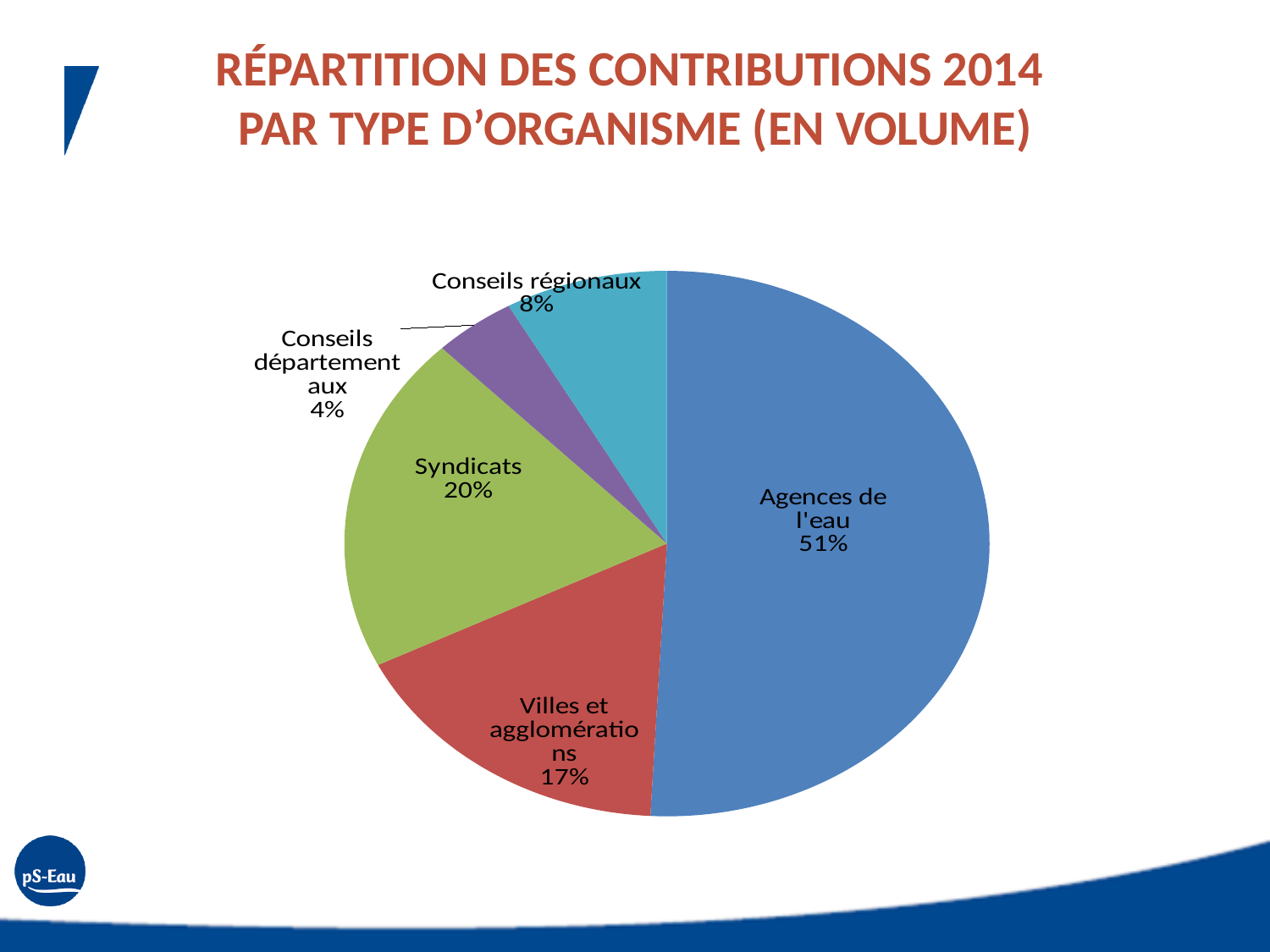
How many slices does the pie chart have? 5 What percentage is shown for Conseils départementaux? 4% Which is larger, the share for Conseils régionaux or the share for Conseils départementaux? Conseils régionaux What percentage is shown for Syndicats? 20% Which type of organisme has the largest share of contributions? Agences de l'eau What percentage is shown for Conseils régionaux? 8% What percentage is shown for Villes et agglomérations? 17% What share of the pie does Agences de l'eau represent? 51% What is the title of the chart on the slide? Répartition des contributions 2014 par type d'organisme (en volume) Which type of organisme has the smallest share of contributions? Conseils départementaux What is the difference in percentage points between Syndicats and Villes et agglomérations? 3 What kind of chart is shown on the slide? Pie chart